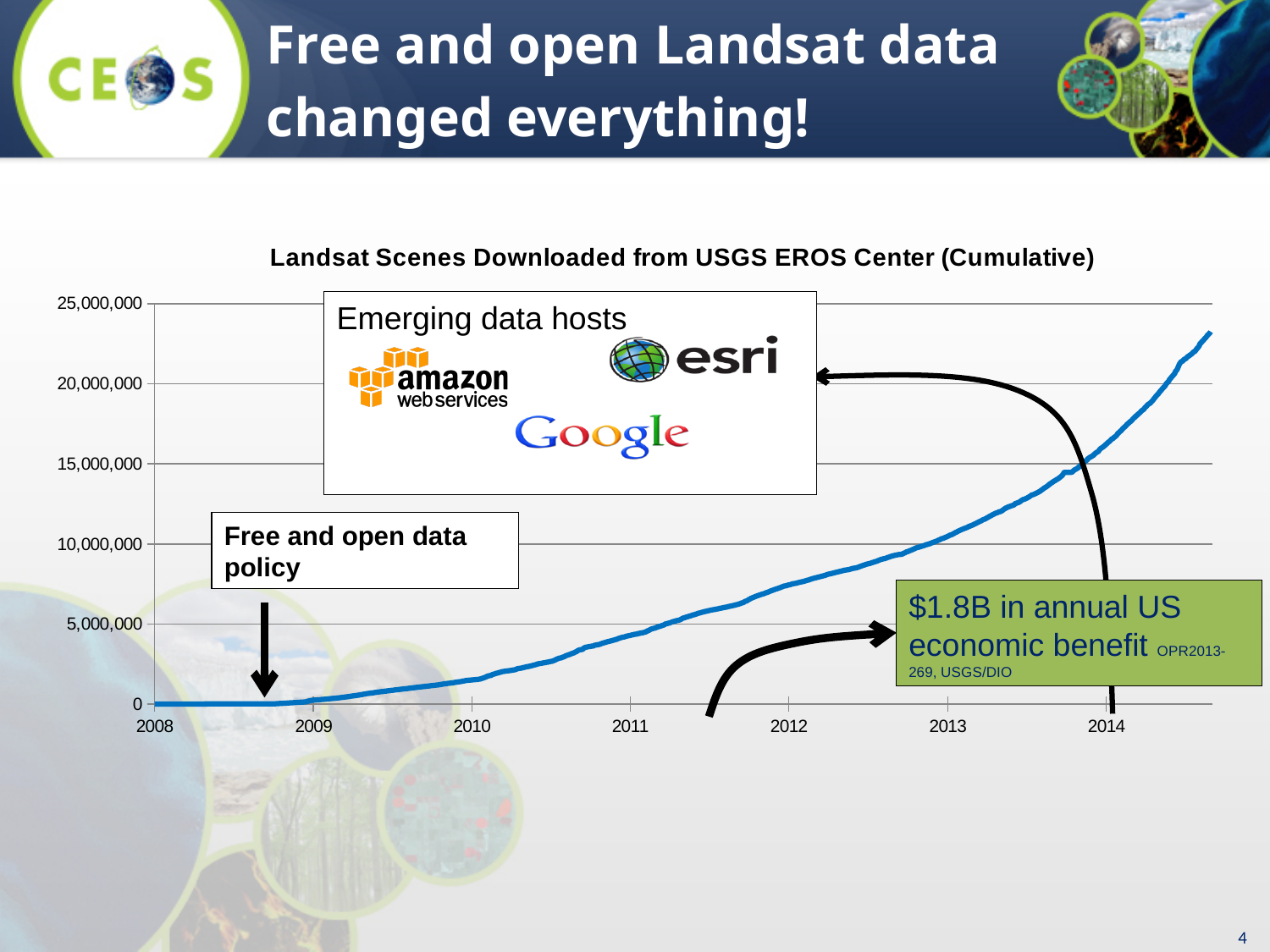
Is the cumulative value at the end of the line (after 2014) greater or less than 20,000,000? greater What is the title of the chart? Landsat Scenes Downloaded from USGS EROS Center (Cumulative) How many year labels are shown on the x axis? 7 Do the cumulative downloads rise or fall from 2008 to 2014? rise Which year on the x axis has the highest cumulative downloads? 2014 What is the highest value labelled on the y axis? 25,000,000 Is the cumulative value at 2012 greater or less than 5,000,000? greater Is the cumulative value at 2010 greater or less than 5,000,000? less What kind of chart is shown on the slide? line chart Which year on the x axis has the lowest cumulative downloads? 2008